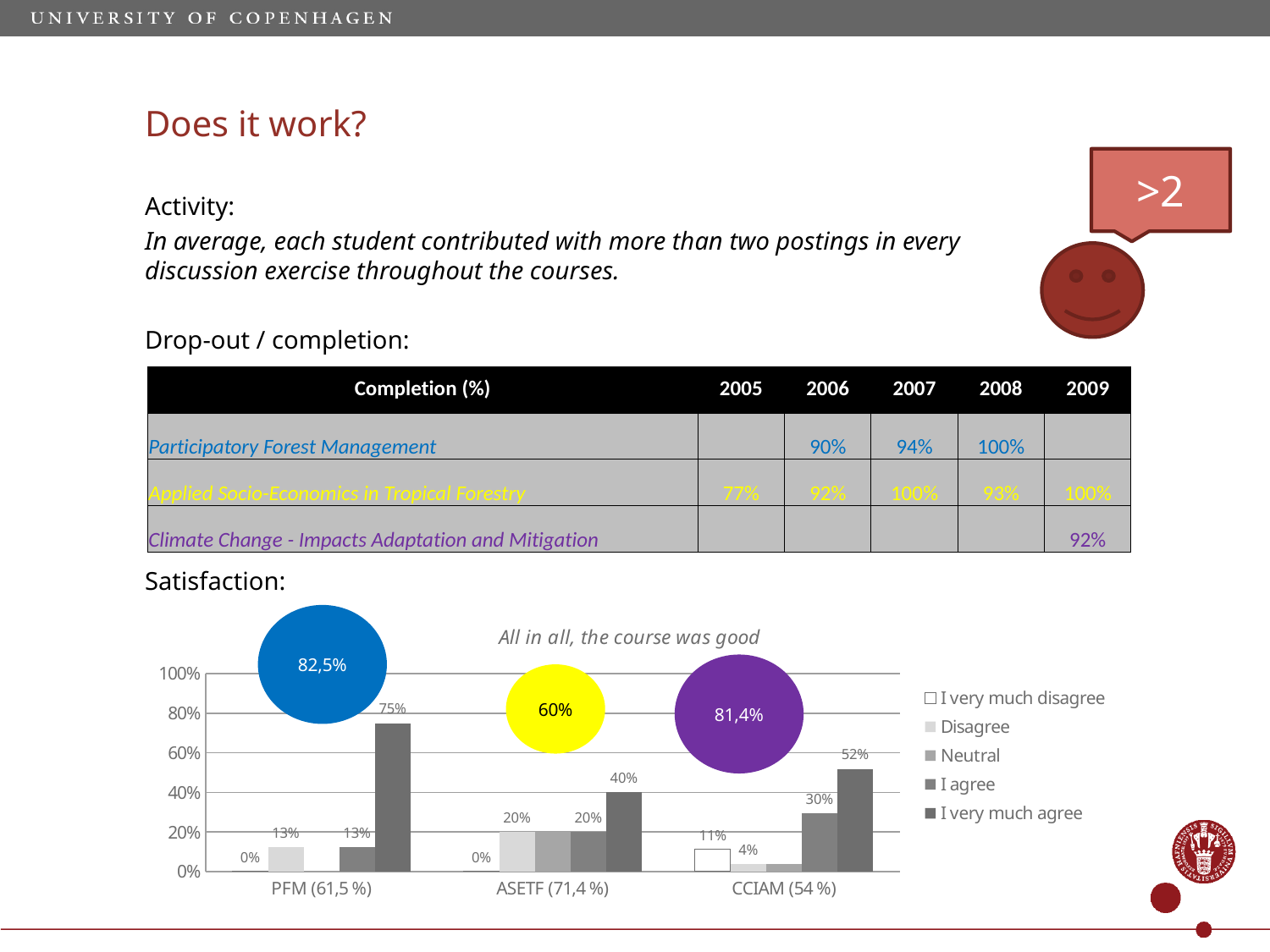
How many course categories are shown on the x axis of the 'All in all, the course was good' chart? 3 Which course has the highest 'I very much agree' value in the 'All in all, the course was good' chart? PFM (61,5 %) How many series does the legend of the 'All in all, the course was good' chart list? 5 In the 'All in all, the course was good' chart, which has the larger 'I agree' value: CCIAM (54 %) or ASETF (71,4 %)? CCIAM (54 %) In the 'All in all, the course was good' chart, what is the 'Disagree' value for ASETF (71,4 %)? 20% In the 'All in all, the course was good' chart, what is the 'I very much agree' value for PFM (61,5 %)? 75% In the 'All in all, the course was good' chart, what is the 'I very much agree' value for CCIAM (54 %)? 52% What kind of chart is shown under 'Satisfaction'? bar chart In the 'All in all, the course was good' chart, what is the 'I very much agree' value for ASETF (71,4 %)? 40% What is the title of the bar chart under 'Satisfaction'? All in all, the course was good In the 'All in all, the course was good' chart, what is the 'I very much disagree' value for CCIAM (54 %)? 11% In the 'All in all, the course was good' chart, what is the difference between the 'I very much agree' values for PFM (61,5 %) and ASETF (71,4 %)? 35%